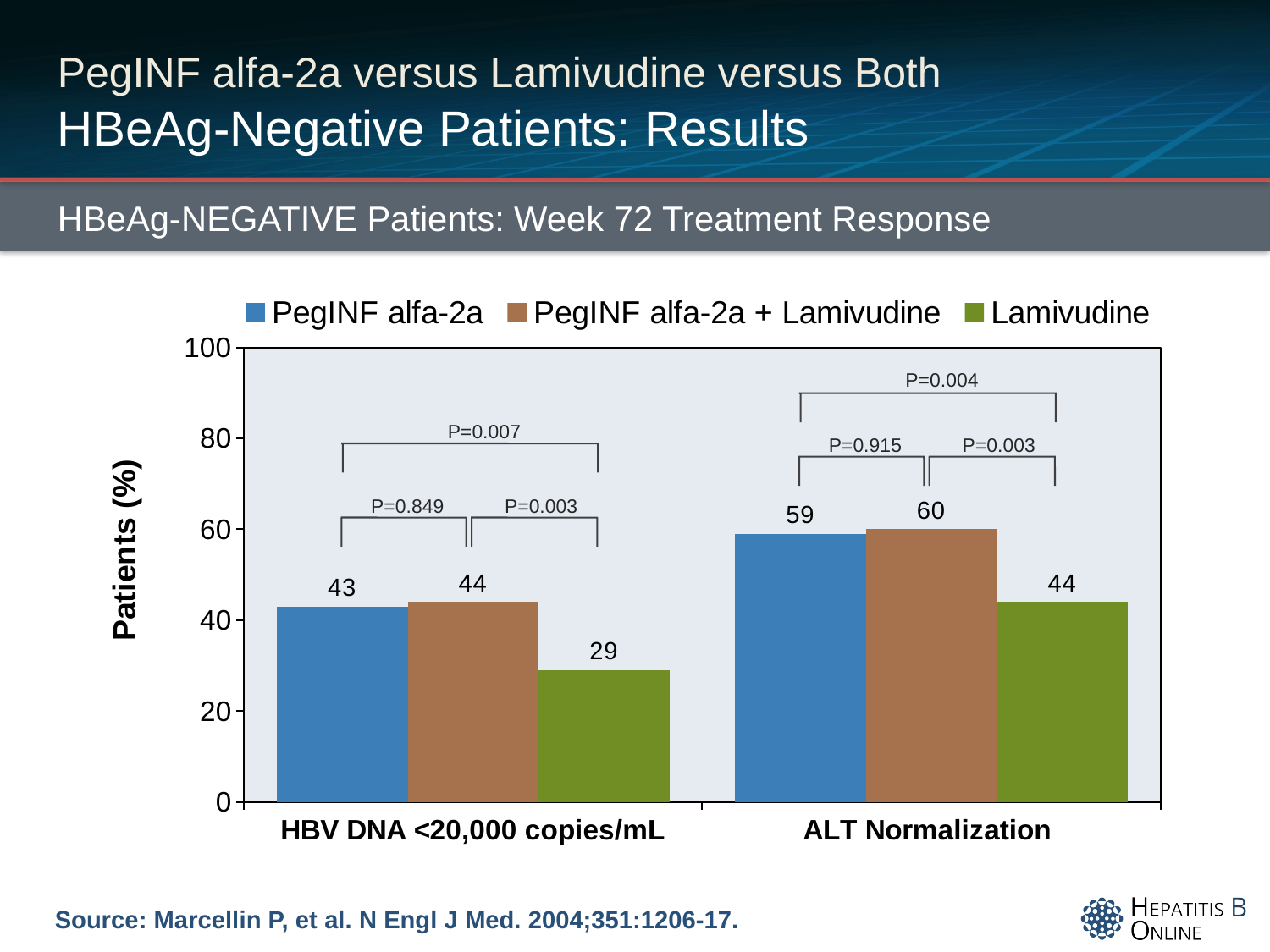
Which is larger: the Lamivudine value for ALT Normalization or the Lamivudine value for HBV DNA <20,000 copies/mL? ALT Normalization Which treatment group had the lowest percentage of patients with HBV DNA <20,000 copies/mL? Lamivudine What is the difference between the PegINF alfa-2a value for ALT Normalization and its value for HBV DNA <20,000 copies/mL? 16 What is the difference between the PegINF alfa-2a + Lamivudine and Lamivudine values for HBV DNA <20,000 copies/mL? 15 How many series does the legend list? 3 What kind of chart is shown on the slide? Bar chart Which treatment group had the highest percentage of patients with ALT Normalization? PegINF alfa-2a + Lamivudine What percentage of patients in the PegINF alfa-2a group achieved HBV DNA <20,000 copies/mL? 43 What percentage of patients in the Lamivudine group achieved ALT Normalization? 44 Is the value for PegINF alfa-2a in the ALT Normalization category greater or less than 40? greater What P value is shown for the comparison between PegINF alfa-2a and Lamivudine in the ALT Normalization category? P=0.004 What is the value for PegINF alfa-2a + Lamivudine in the ALT Normalization category? 60